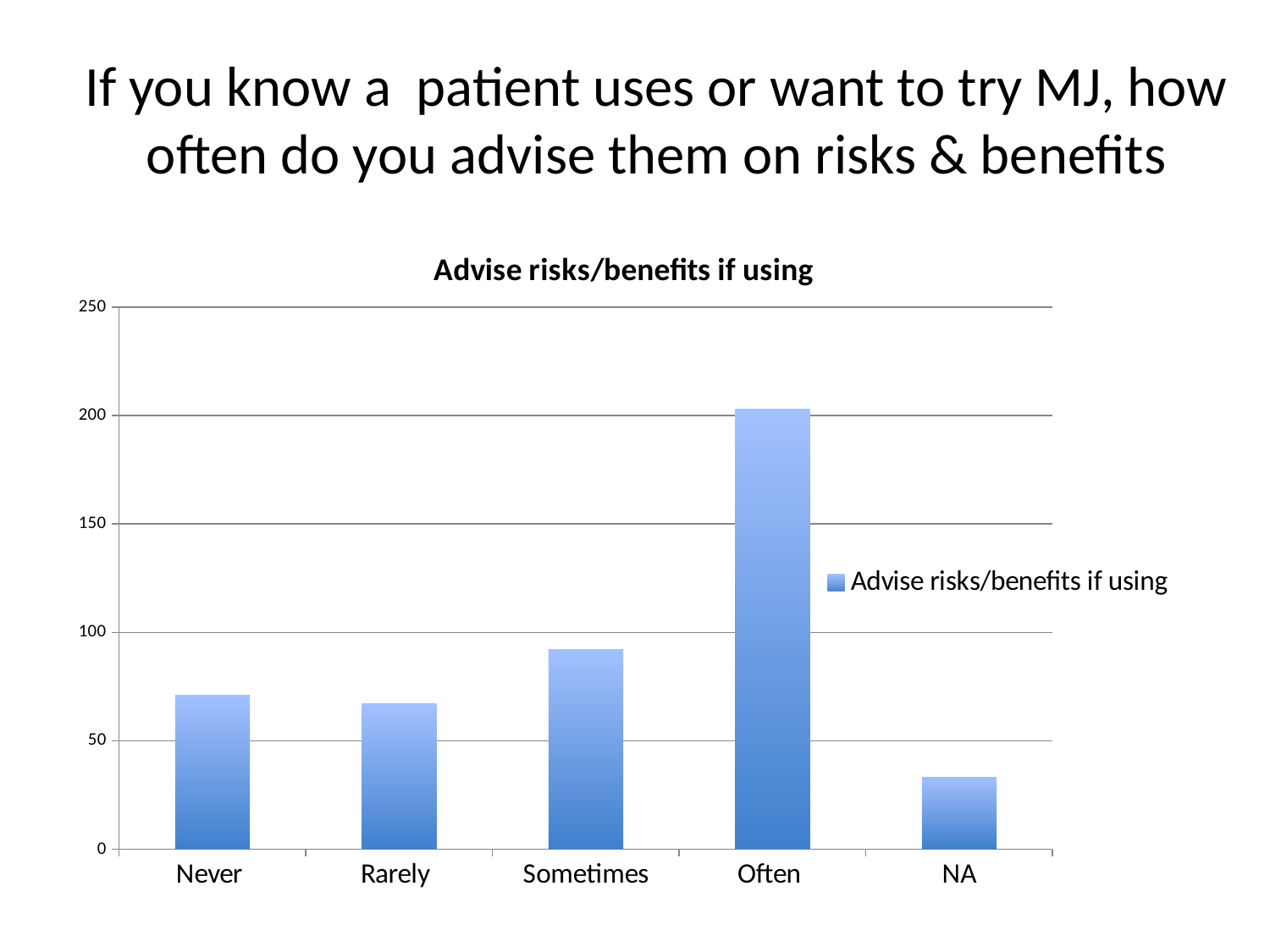
What is the title of the chart? Advise risks/benefits if using How many series does the chart's legend list? 1 Is the value for NA greater or less than 50? less What kind of chart is shown on the slide? bar chart Which category has the lowest bar? NA Which is larger, the value for Sometimes or the value for Never? Sometimes Is the value for Sometimes greater or less than 100? less How many categories are shown on the x axis of the chart? 5 Is the value for Never greater or less than 50? greater Which is larger, the value for Rarely or the value for NA? Rarely Which category has the highest bar? Often